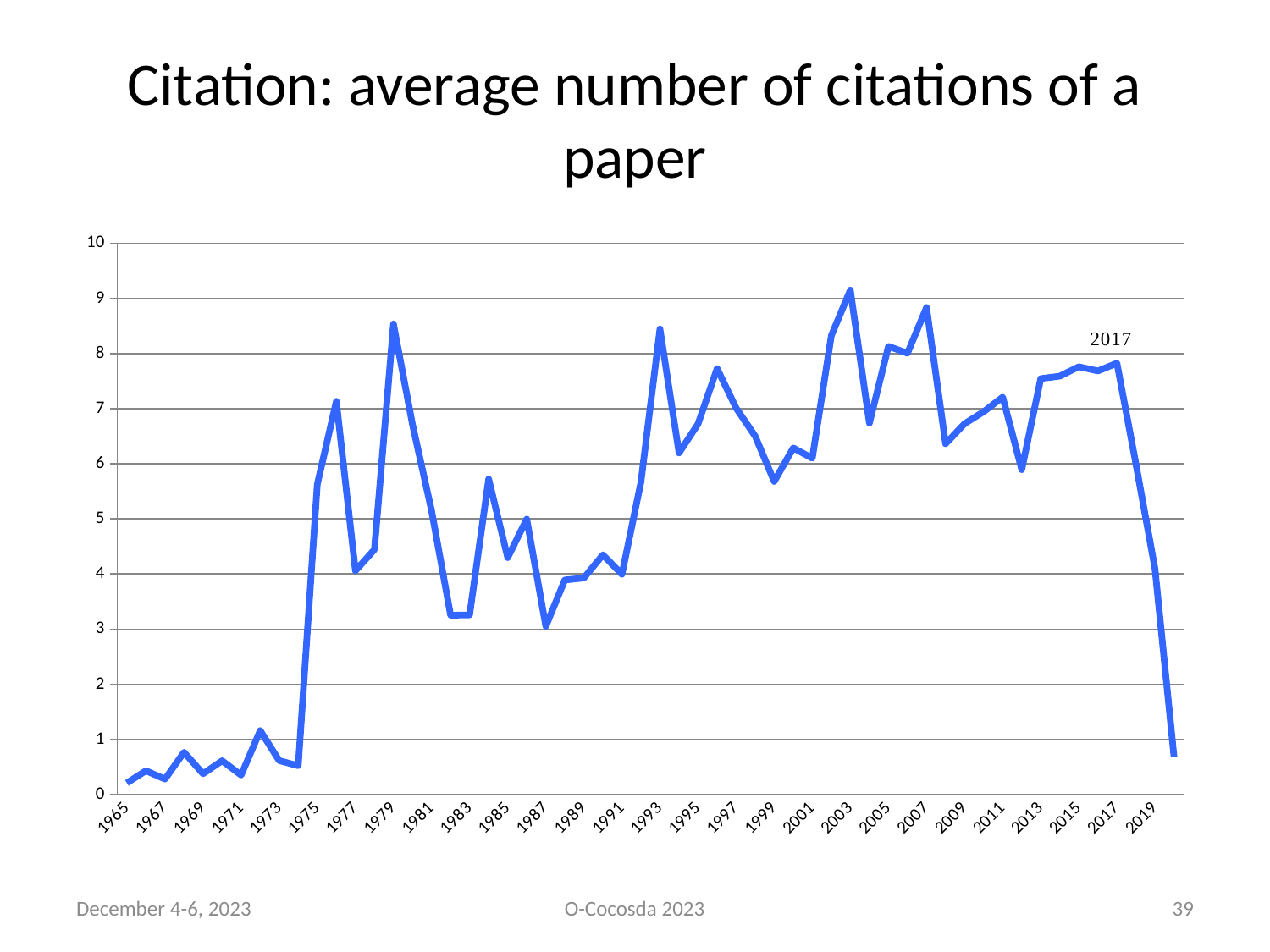
Which year has the larger value, 1993 or 1995? 1993 Is the value for 1987 greater or less than 4? less Which year has the highest average number of citations? 2003 What kind of chart is shown on the slide? line chart Is the value for 2017 greater or less than 7? greater Is the value for 1983 greater or less than 4? less Which year has the larger value, 1979 or 1983? 1979 What colour is the line in the chart? blue What is the title of the chart? Citation: average number of citations of a paper Does the line rise or fall between 2017 and the last point on the chart? fall